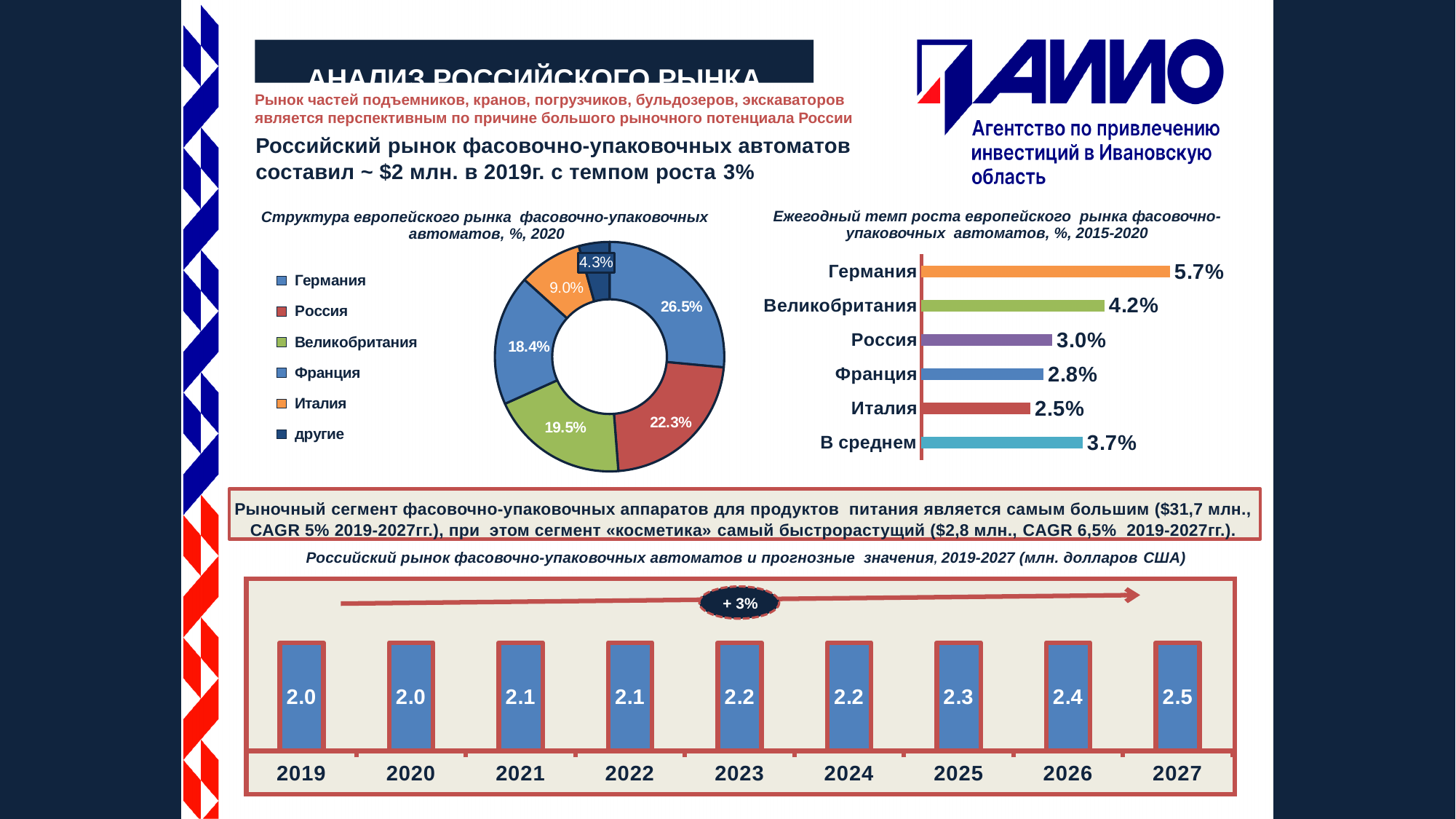
In the donut chart on the left, what is the difference between the shares of Россия and Великобритания? 2.8% In the horizontal bar chart on the right, which is larger: the value for Россия or the value for Франция? Россия In the bottom chart (Russian market 2019-2027), do the values rise or fall from 2019 to 2027? rise In the donut chart on the left (structure of the European market, 2020), which country has the smallest labelled share among the named countries? Италия In the horizontal bar chart on the right (annual growth rate 2015-2020), what is the value for Великобритания? 4.2% In the donut chart on the left (structure of the European market, 2020), what share does Германия have? 26.5% In the horizontal bar chart on the right, what is the difference between the value for Германия and the value for Италия? 3.2% In the bottom chart (Russian market 2019-2027), what is the value for 2027? 2.5 What type of chart is the chart at the bottom of the slide (Russian market 2019-2027)? bar chart In the horizontal bar chart on the right (annual growth rate 2015-2020), which country has the highest growth rate? Германия How many legend entries does the donut chart on the left list? 6 How many years are shown on the x axis of the bottom chart (Russian market 2019-2027)? 9